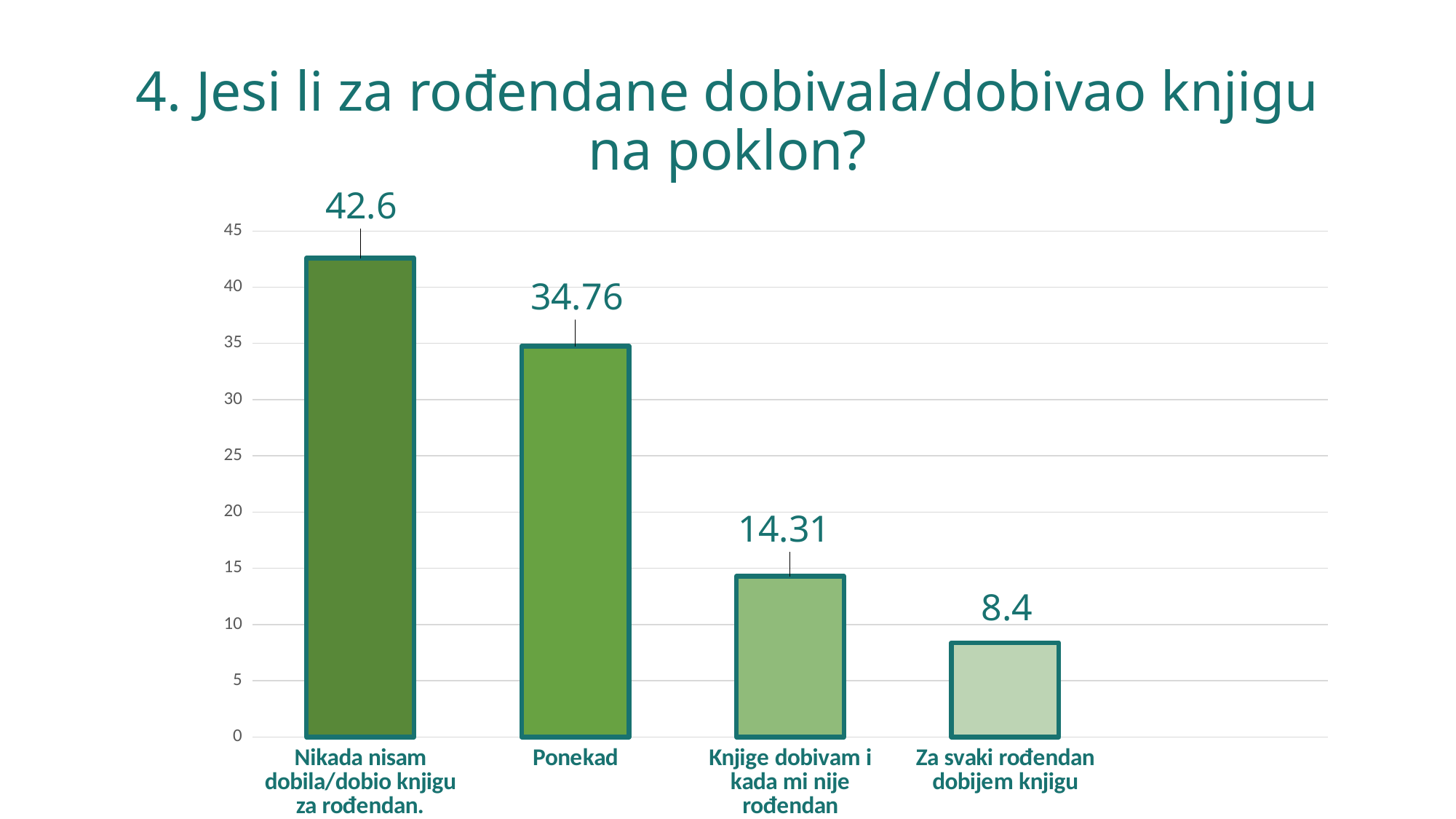
What is the title of the slide? 4. Jesi li za rođendane dobivala/dobivao knjigu na poklon? Which category has the lowest value? Za svaki rođendan dobijem knjigu What is the value for "Za svaki rođendan dobijem knjigu"? 8.4 Which is larger, the value for "Knjige dobivam i kada mi nije rođendan" or the value for "Za svaki rođendan dobijem knjigu"? Knjige dobivam i kada mi nije rođendan How many categories are shown in the chart? 4 What is the value for "Ponekad"? 34.76 What is the value for "Knjige dobivam i kada mi nije rođendan"? 14.31 Do the values rise or fall from left to right across the categories? fall Is the value for "Ponekad" greater or less than 30? greater Which category has the highest value? Nikada nisam dobila/dobio knjigu za rođendan. What kind of chart is shown on the slide? bar chart What is the difference between the values for "Nikada nisam dobila/dobio knjigu za rođendan." and "Ponekad"? 7.84